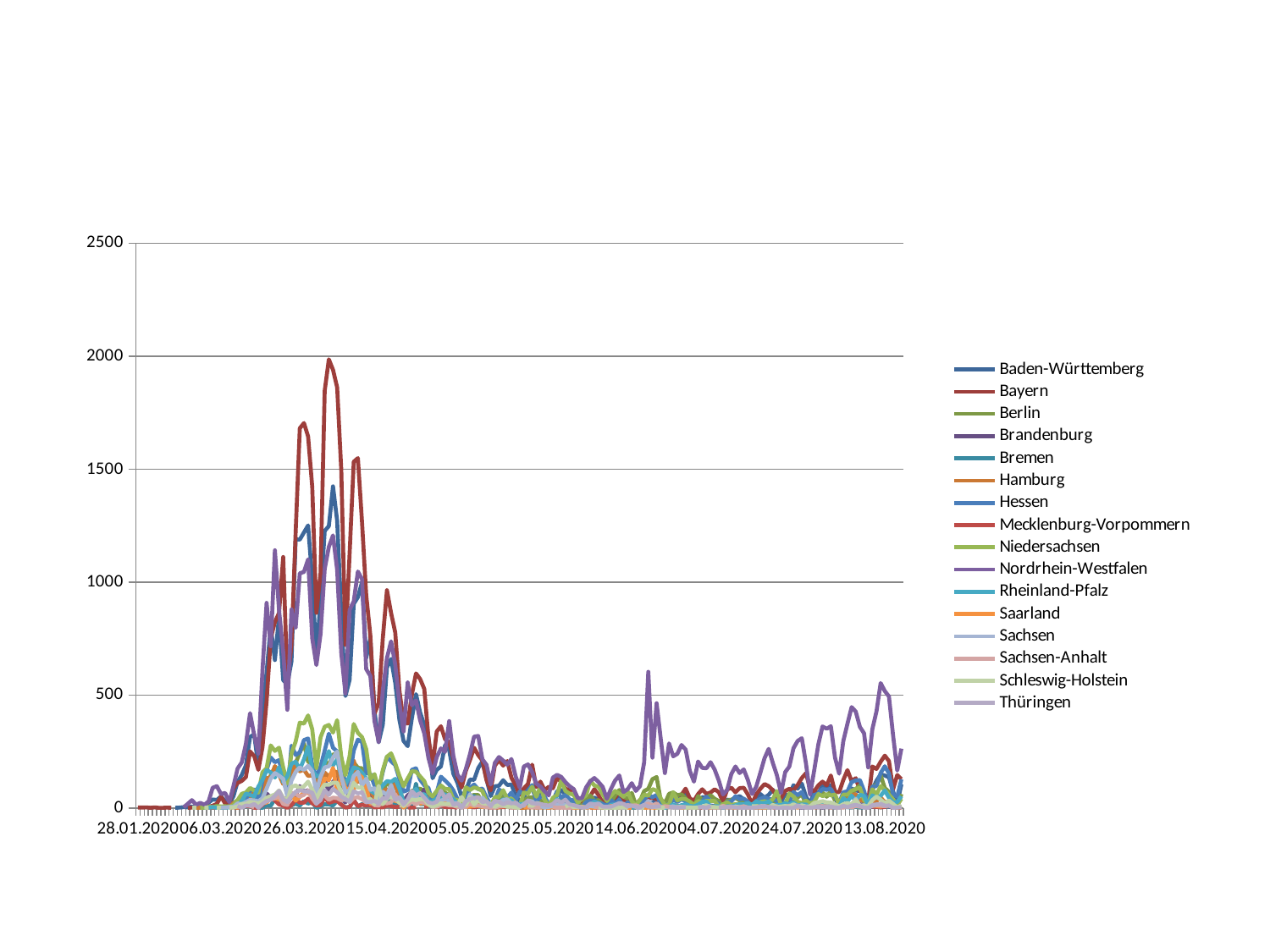
Do the values for Bayern rise or fall between 15.04.2020 and 25.05.2020? fall What kind of chart is shown on the slide? line chart How many series does the legend list? 16 Is the value for Bayern at 28.01.2020 greater or less than 500? less How many date labels are shown on the x axis? 10 Is the peak value for Bayern greater or less than 1500? greater What is the highest value shown on the y axis? 2500 What is the first entry listed in the legend? Baden-Württemberg Which series reaches a higher peak, Bayern or Hamburg? Bayern Which series has the highest values around 13.08.2020? Nordrhein-Westfalen Which series reaches the highest peak value on the chart? Bayern Is the highest value reached by Nordrhein-Westfalen in August 2020 greater or less than 1000? less